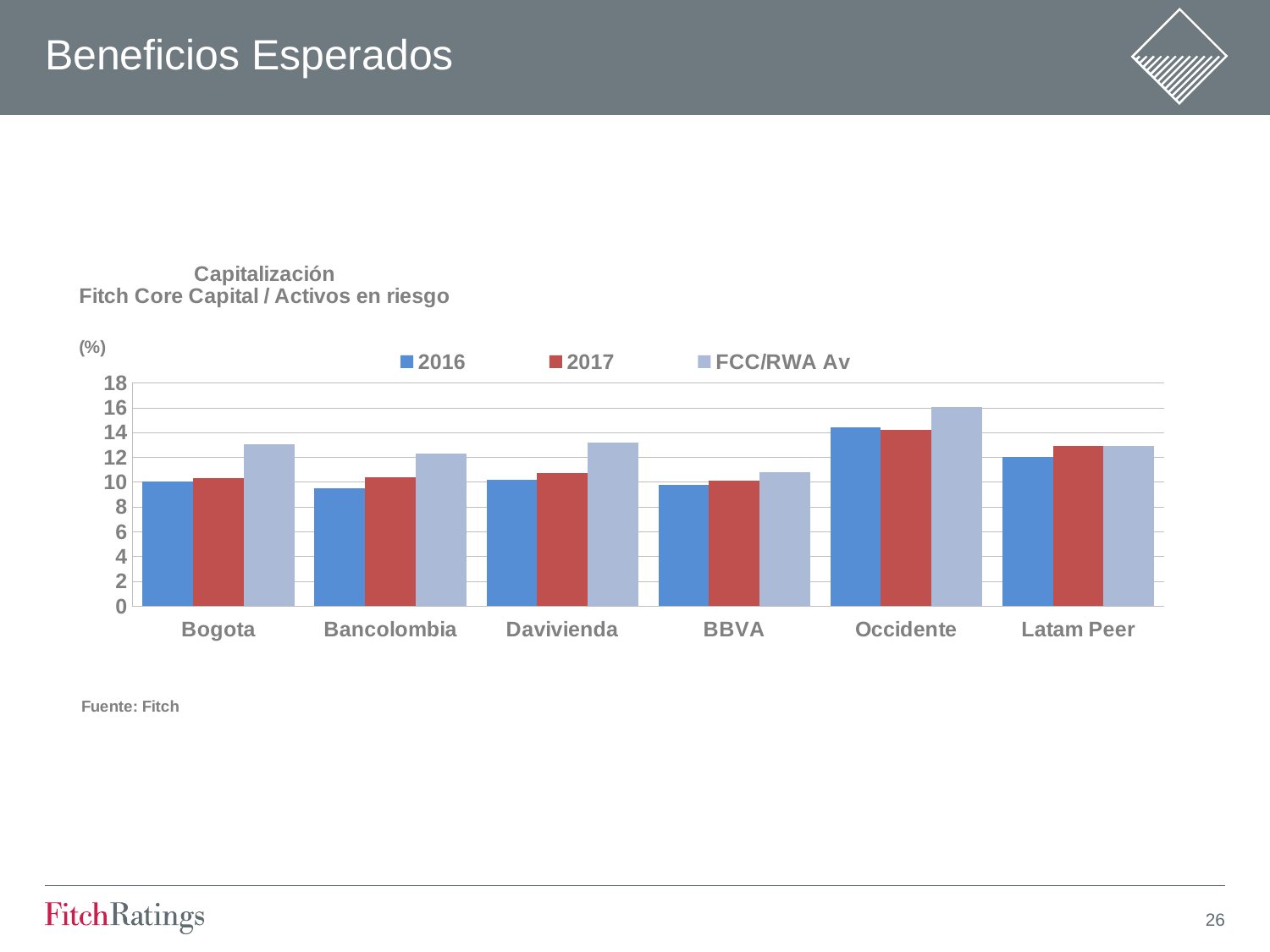
Is the 2016 value for Bancolombia greater or less than 10? less How many series does the legend list? 3 Which is larger: the FCC/RWA Av value for Bancolombia or the FCC/RWA Av value for BBVA? Bancolombia How many categories are shown on the x axis? 6 Is the FCC/RWA Av value for BBVA greater or less than 12? less What unit is shown on the y axis of the chart? (%) Is the FCC/RWA Av value for Occidente greater or less than 14? greater Which category has the highest FCC/RWA Av value? Occidente Which category has the highest 2016 value? Occidente What kind of chart is shown on the slide? bar chart Which category has the lowest FCC/RWA Av value? BBVA Which is larger: the 2016 value for Occidente or the 2016 value for Latam Peer? Occidente